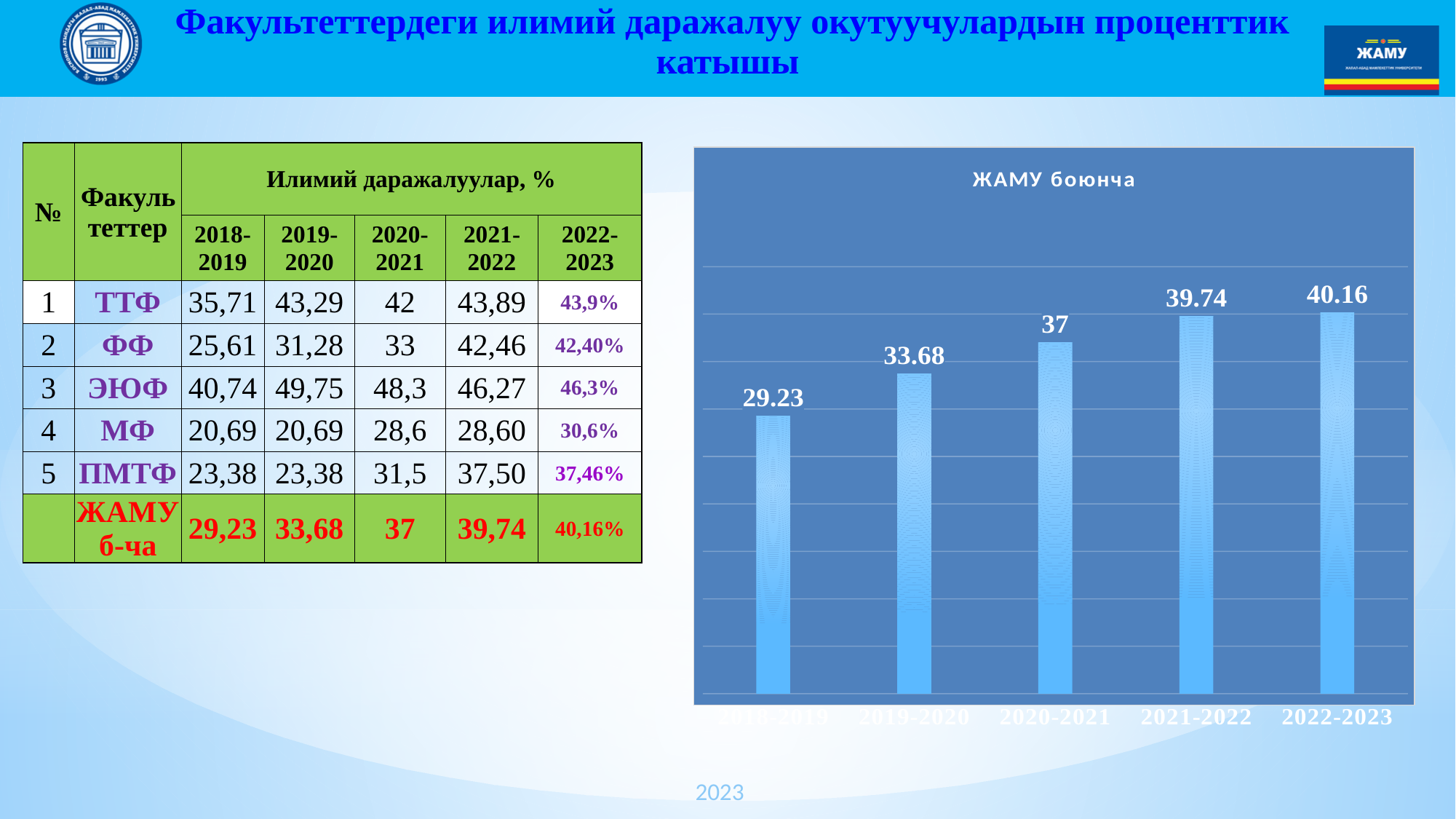
Which is larger, the value for 2019-2020 or the value for 2020-2021? 2020-2021 What is the value for 2018-2019 in the chart? 29.23 Do the values rise or fall from 2018-2019 to 2022-2023? Rise What kind of chart is shown on the slide? Bar chart What is the value for 2019-2020 in the chart? 33.68 Which year has the lowest value in the chart? 2018-2019 What is the value for 2022-2023 in the chart? 40.16 What is the value for 2020-2021 in the chart? 37 What is the value for 2021-2022 in the chart? 39.74 Which year has the highest value in the chart? 2022-2023 What is the difference between the values for 2022-2023 and 2018-2019? 10.93 How many bars are shown in the chart? 5